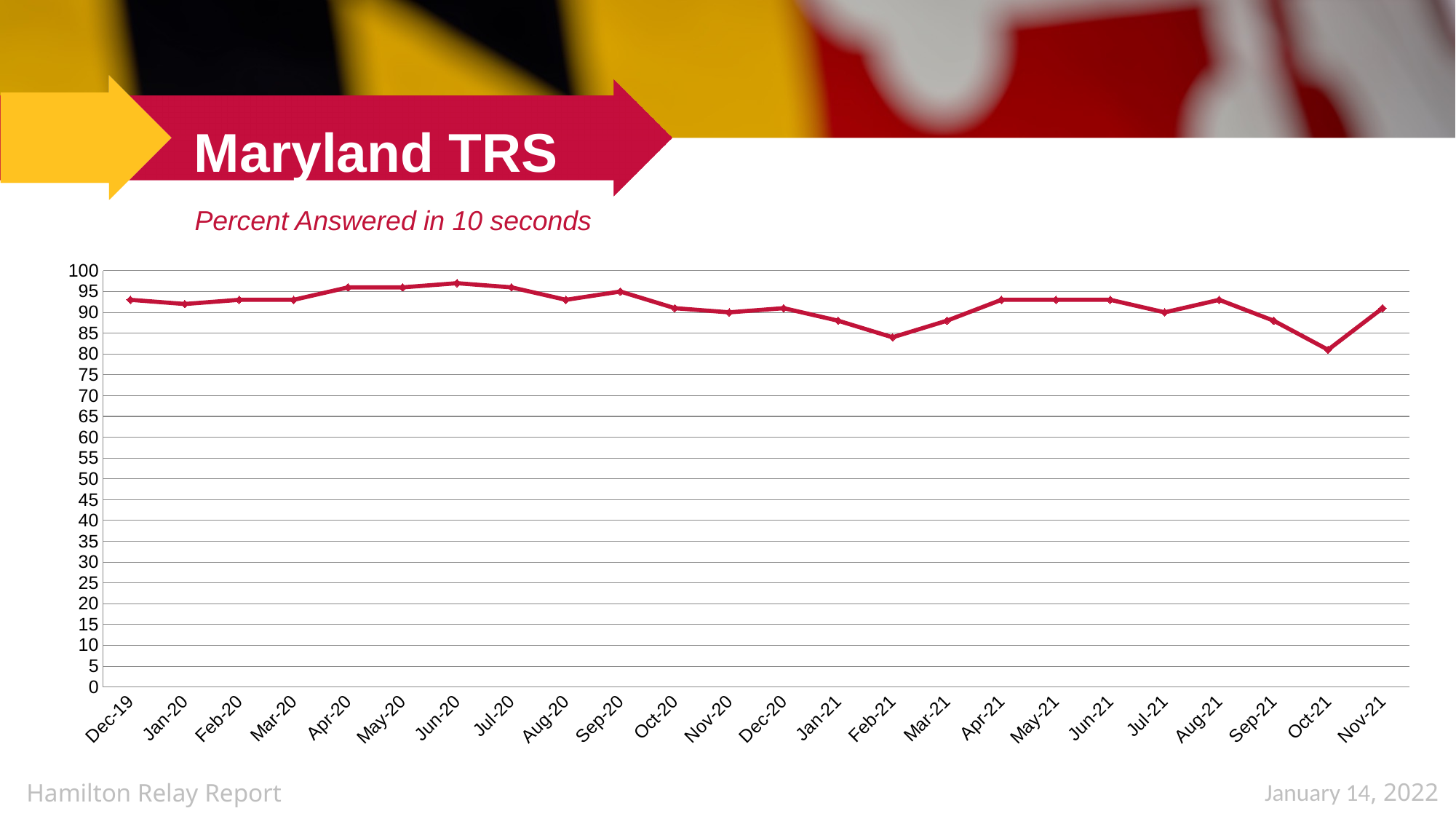
Which month has the lowest percent answered in 10 seconds? Oct-21 Is the value for Feb-21 greater or less than 90? less Which is larger, the value for Feb-21 or the value for Apr-21? Apr-21 Which is larger, the value for Jun-20 or the value for Oct-21? Jun-20 Does the line rise or fall from Aug-21 to Oct-21? fall How many monthly data points are plotted on the chart? 24 Is the value for Oct-21 greater or less than 85? less What is the title of the chart? Percent Answered in 10 seconds Which month has the highest percent answered in 10 seconds? Jun-20 What kind of chart is shown on the slide? line chart Is the value for Dec-19 greater or less than 90? greater